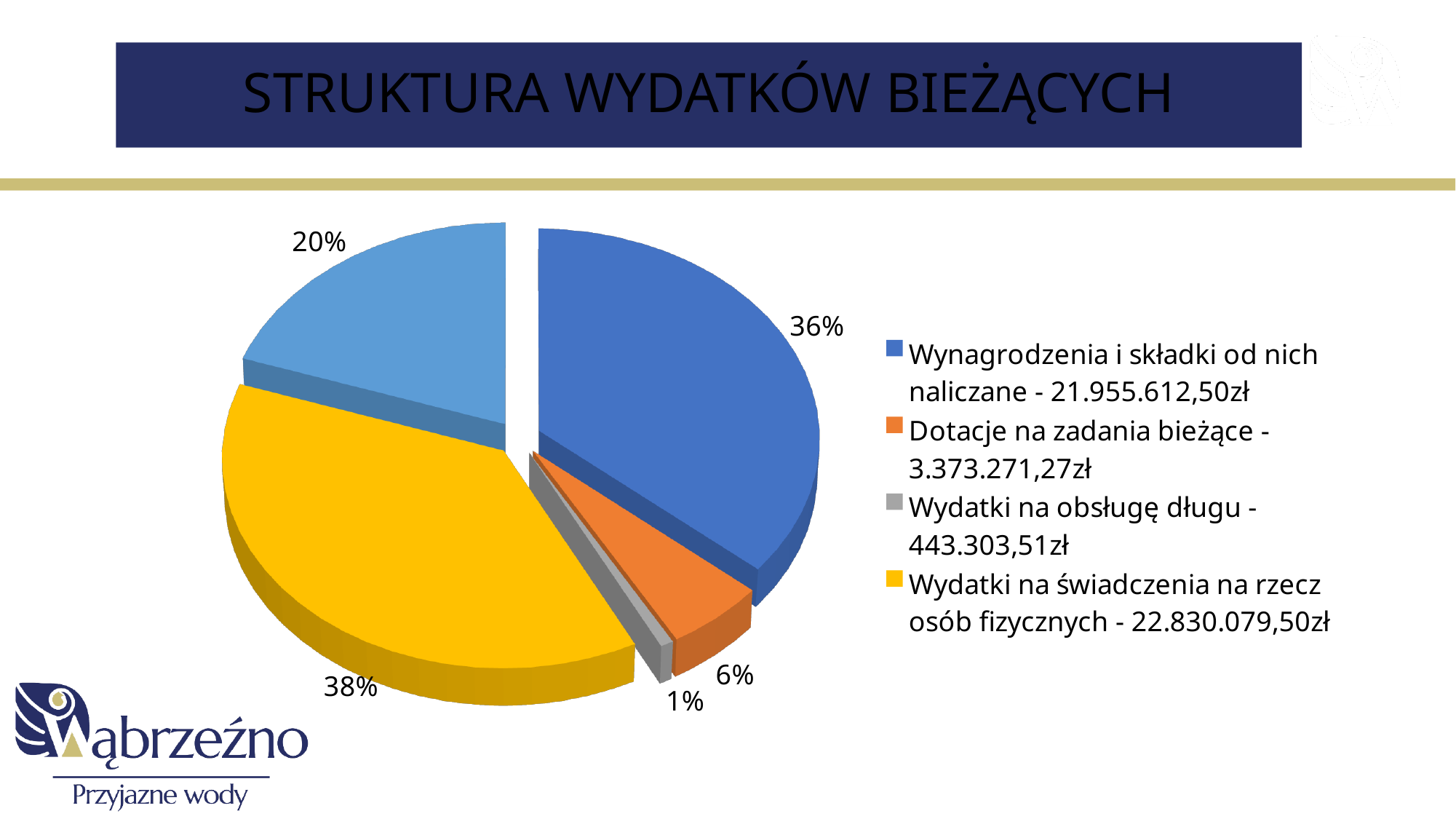
What share of the pie does 'Wynagrodzenia i składki od nich naliczane' represent? 36% Which category has the smallest slice of the pie? Wydatki na obsługę długu What type of chart is shown on the slide? pie chart How many slices does the pie chart have? 5 What share of the pie does 'Dotacje na zadania bieżące' represent? 6% What is the difference in percentage points between the 'Wydatki na świadczenia na rzecz osób fizycznych' slice and the 'Wynagrodzenia i składki od nich naliczane' slice? 2 percentage points How many entries does the legend list? 4 Which category has the largest slice of the pie? Wydatki na świadczenia na rzecz osób fizycznych What share of the pie does 'Wydatki na obsługę długu' represent? 1% Which is larger: the slice for 'Dotacje na zadania bieżące' or the slice for 'Wydatki na obsługę długu'? Dotacje na zadania bieżące What is the title of the chart on the slide? STRUKTURA WYDATKÓW BIEŻĄCYCH